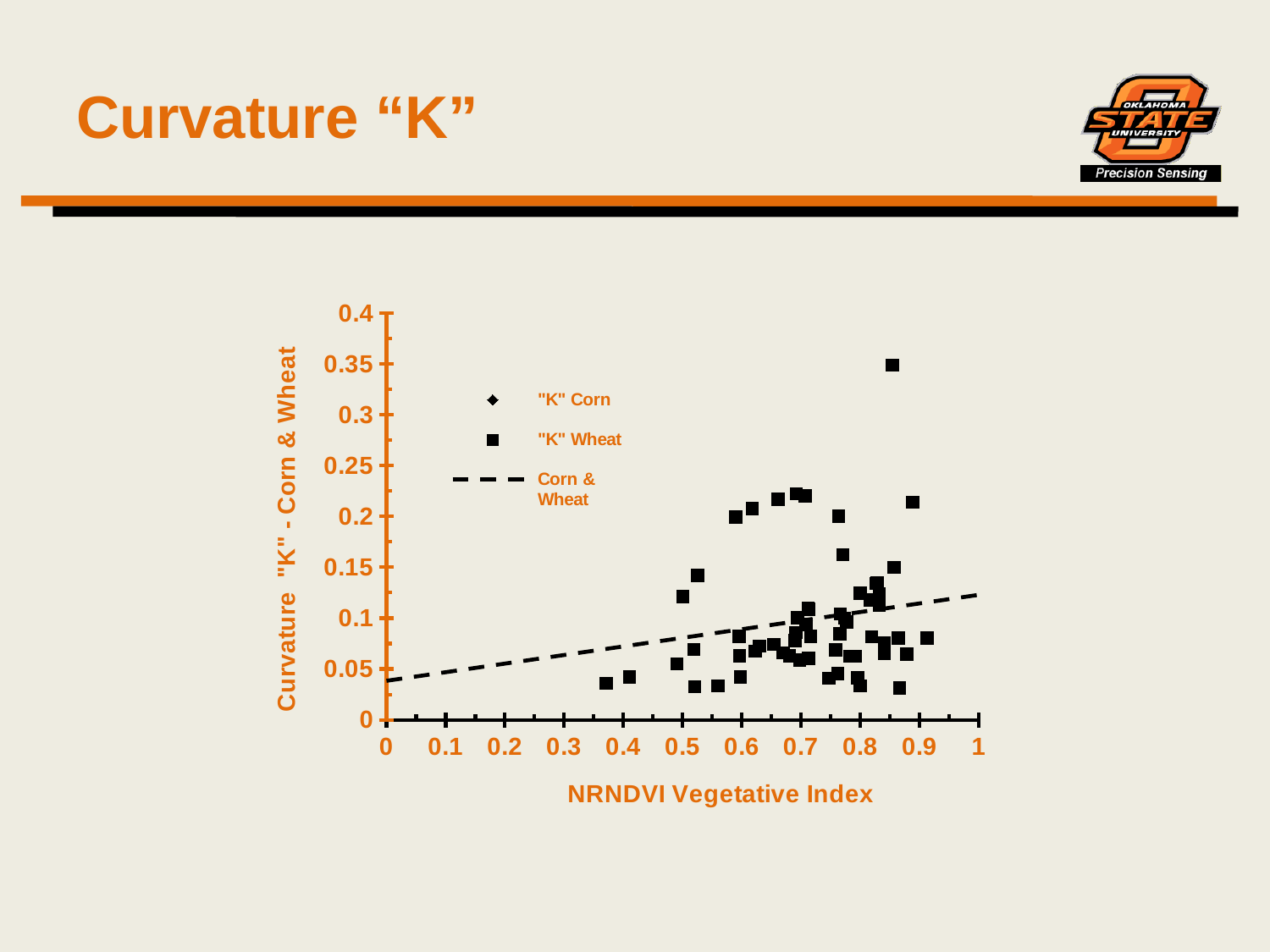
Is the value of the dashed "Corn & Wheat" line at an NRNDVI Vegetative Index of 1 greater or less than 0.15? less What kind of chart is shown on the slide? scatter chart What is the title of the x axis of the chart? NRNDVI Vegetative Index How many entries does the chart's legend list? 3 Does the dashed "Corn & Wheat" line rise or fall as the NRNDVI Vegetative Index increases? rise What is the title of the y axis of the chart? Curvature "K" - Corn & Wheat Is the highest plotted "K" Wheat point greater or less than 0.3 on the y axis? greater Is the value of the dashed "Corn & Wheat" line at an NRNDVI Vegetative Index of 0 greater or less than 0.1? less What is the maximum value shown on the y axis of the chart? 0.4